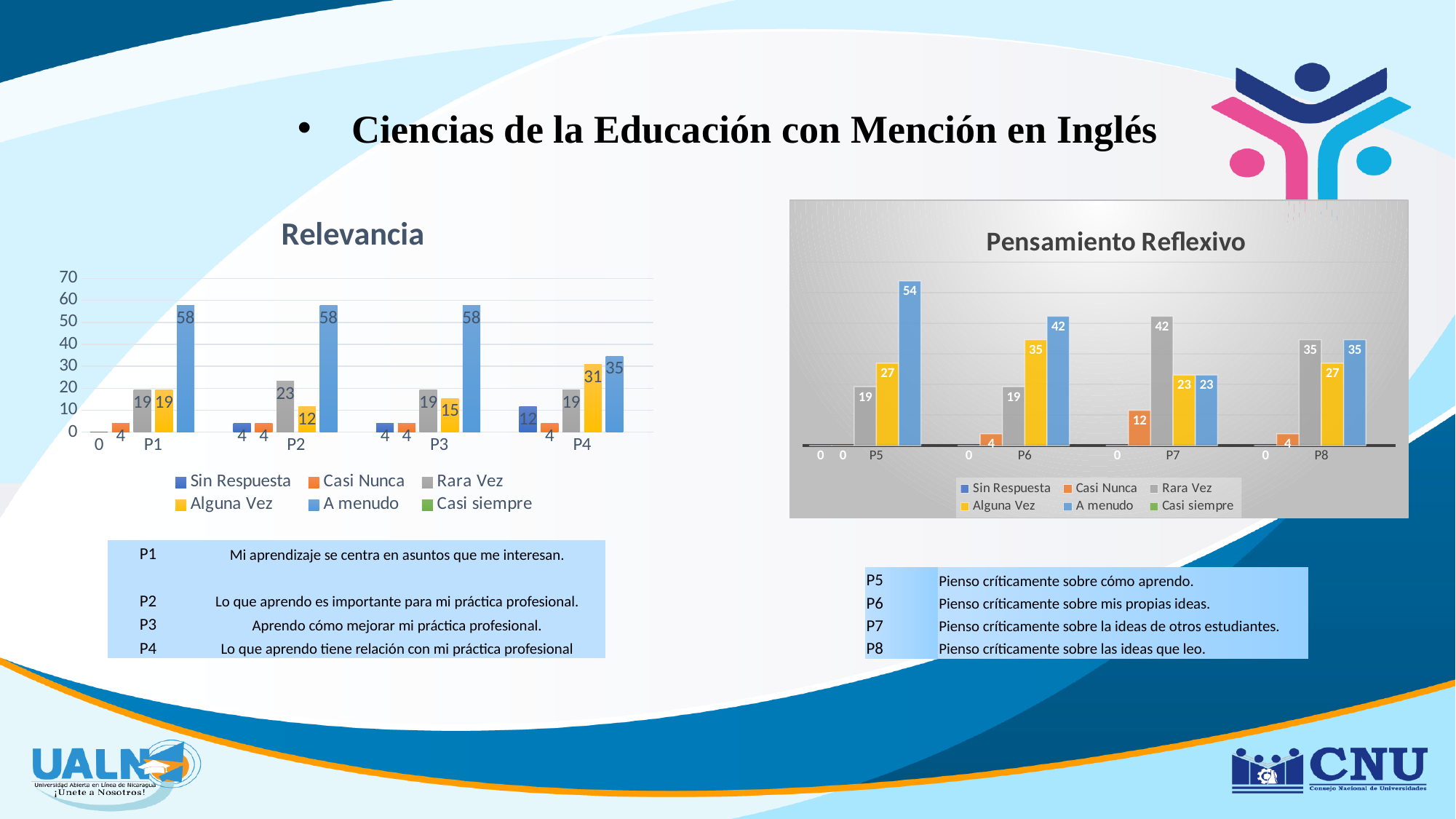
In the Relevancia chart, how many series does the legend list? 6 In the Relevancia chart, what is the value of Rara Vez for P2? 23 In the Relevancia chart, what is the value of Alguna Vez for P4? 31 In the Relevancia chart, what is the difference between A menudo and Alguna Vez for P4? 4 In the Pensamiento Reflexivo chart, what is the value of Rara Vez for P7? 42 In the Relevancia chart, which category has the highest value for Sin Respuesta? P4 In the Pensamiento Reflexivo chart, is the value of Alguna Vez for P6 larger or smaller than the value of Alguna Vez for P8? larger What kind of chart is the Pensamiento Reflexivo chart? bar chart In the Pensamiento Reflexivo chart, what is the value of A menudo for P5? 54 In the Pensamiento Reflexivo chart, which category has the highest value for Casi Nunca? P7 In the Pensamiento Reflexivo chart, how many categories are shown on the x axis? 4 In the Relevancia chart, what is the value of A menudo for P1? 58